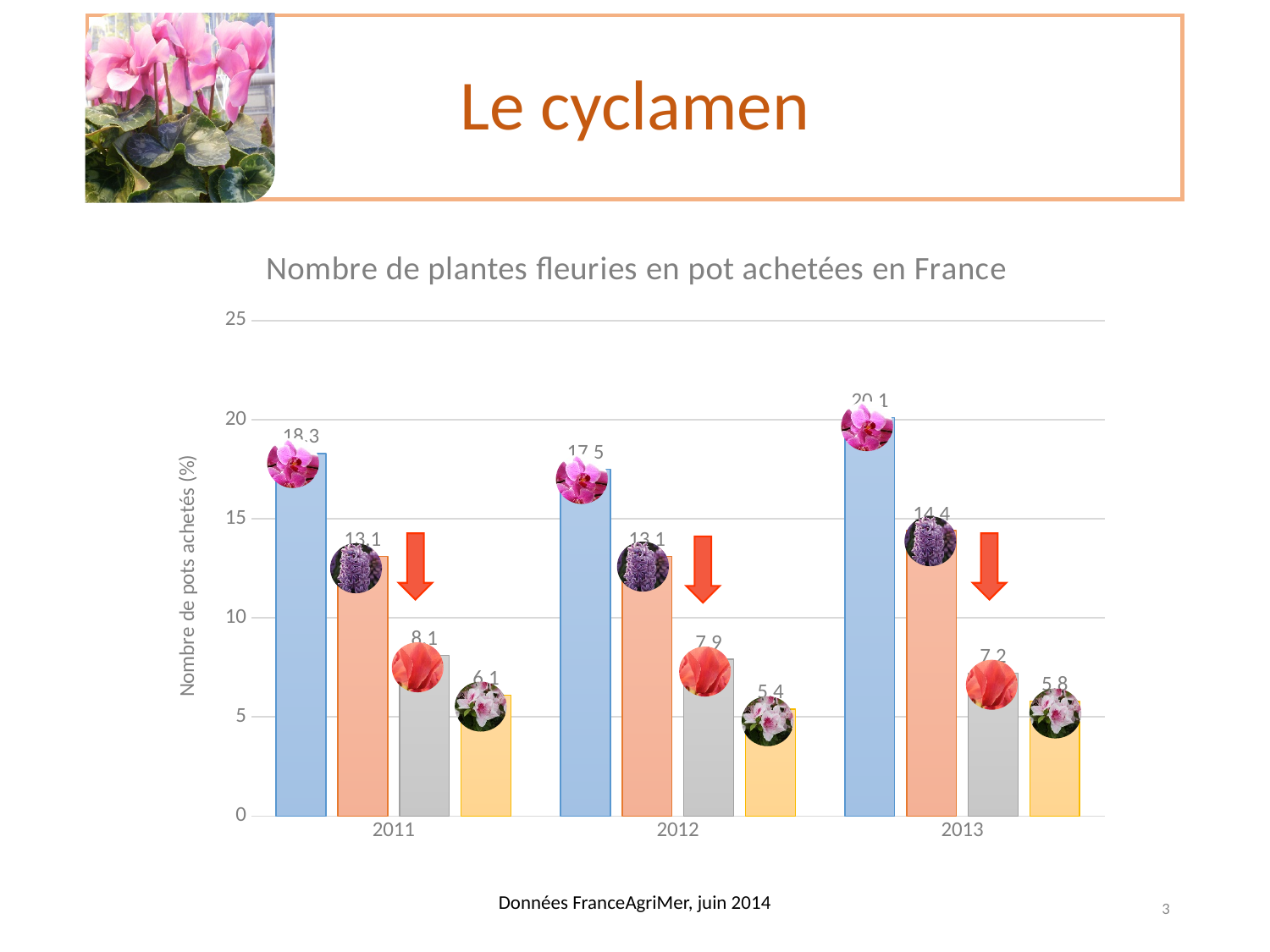
What is the difference between the blue bar for 2013 and the blue bar for 2012? 2.6 In which year is the yellow (fourth) bar lowest? 2012 What is the title of the chart? Nombre de plantes fleuries en pot achetées en France What is the value of the grey (third) bar for 2012? 7.9 In which year is the blue (first) bar highest? 2013 How many years are shown on the x axis of the chart? 3 What is the value of the yellow (fourth) bar for 2011? 6.1 What is the value of the orange (second) bar for 2013? 14.4 What type of chart is shown on the slide? bar chart Which is larger: the grey bar for 2011 or the grey bar for 2013? 2011 What is the value of the blue (first) bar for 2011? 18.3 Do the values of the grey (third) bars rise or fall from 2011 to 2013? fall